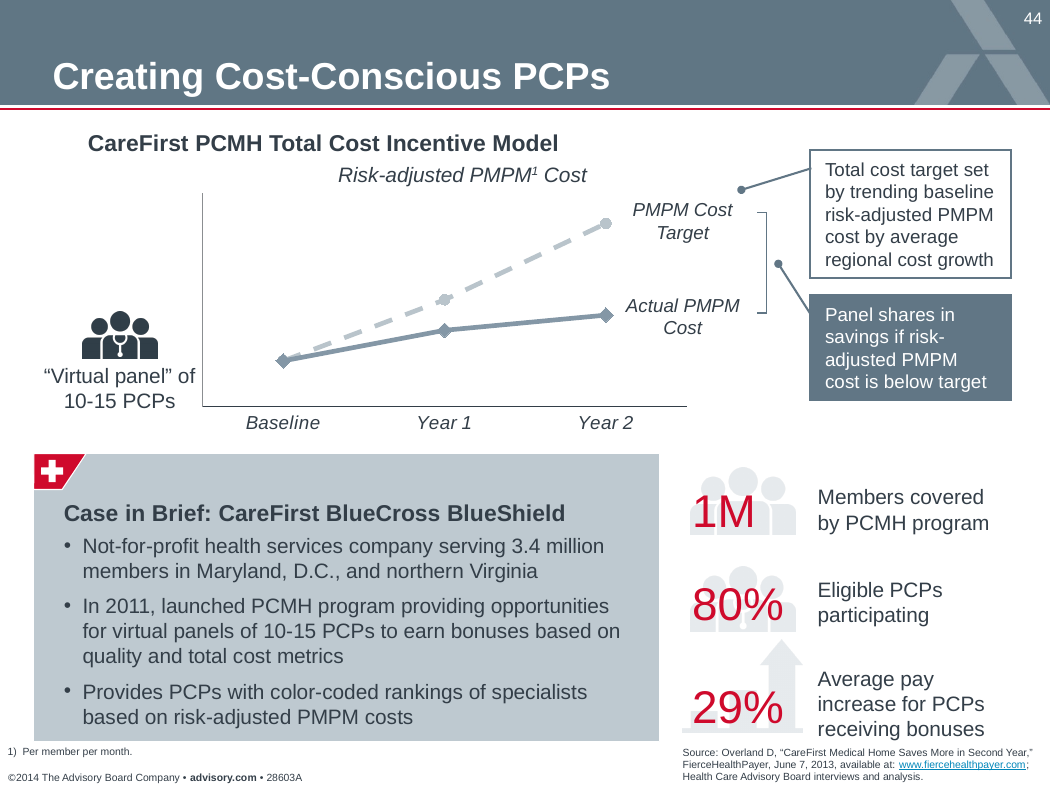
Which series is drawn with a dashed line? PMPM Cost Target What kind of chart is shown under "CareFirst PCMH Total Cost Incentive Model"? Line chart How many points are on the x axis of the chart? 3 How many series are plotted in the chart? 2 Does the Actual PMPM Cost line rise or fall from Baseline to Year 2? Rise At which x-axis point do the two series start from the same value? Baseline What are the categories on the x axis of the chart? Baseline, Year 1, Year 2 Which series reaches the highest point at Year 2? PMPM Cost Target At Year 2, which is higher: PMPM Cost Target or Actual PMPM Cost? PMPM Cost Target What are the two series plotted in the chart? PMPM Cost Target and Actual PMPM Cost Does the PMPM Cost Target line rise or fall from Baseline to Year 2? Rise At Year 1, which is higher: PMPM Cost Target or Actual PMPM Cost? PMPM Cost Target